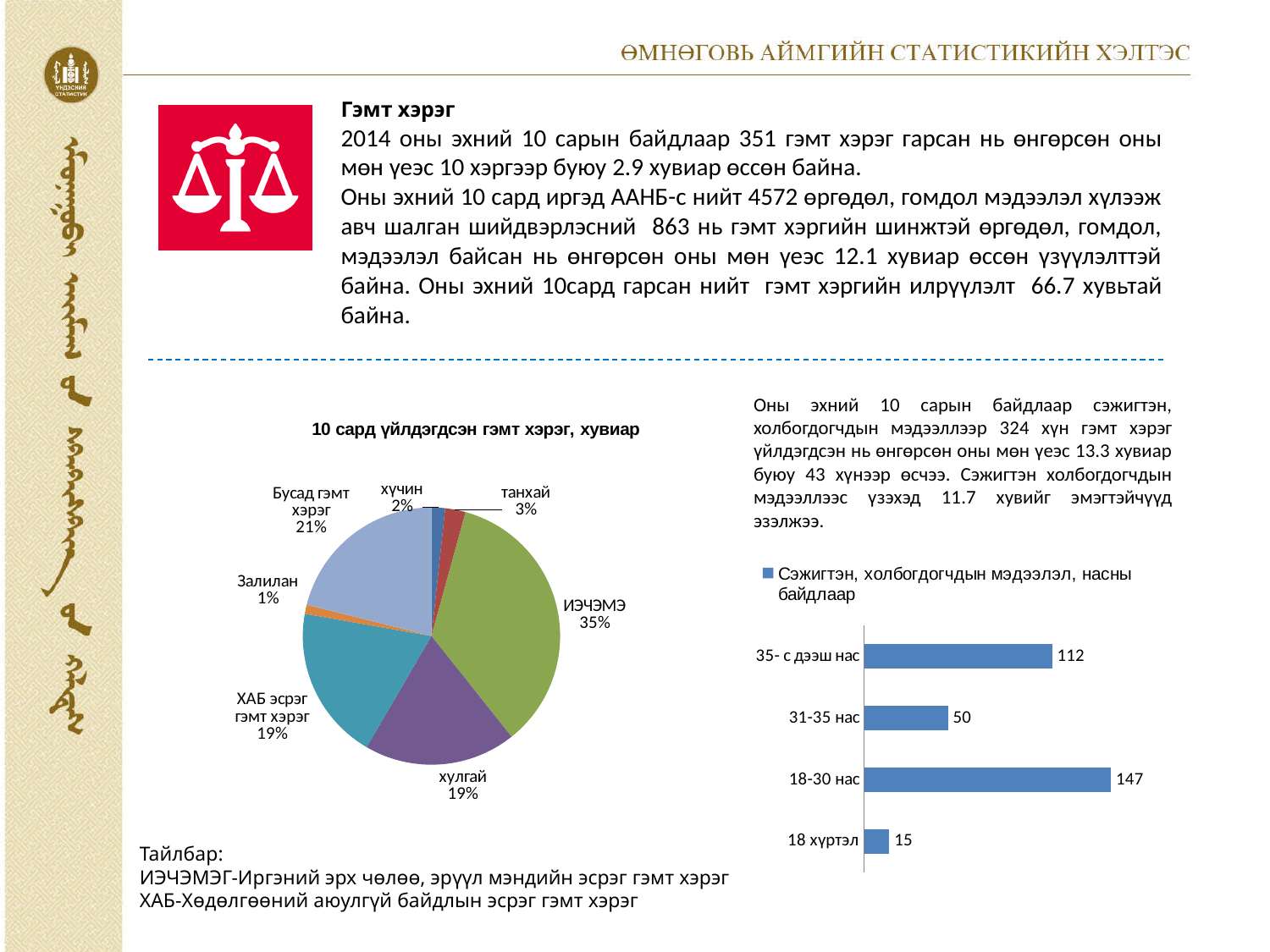
In the bar chart 'Сэжигтэн, холбогдогчдын мэдээлэл, насны байдлаар', what is the value for 31-35 нас? 50 In the bar chart 'Сэжигтэн, холбогдогчдын мэдээлэл, насны байдлаар', which is larger: 35- с дээш нас or 31-35 нас? 35- с дээш нас In the pie chart '10 сард үйлдэгдсэн гэмт хэрэг, хувиар', what is the difference between the shares of ИЭЧЭМЭ and хулгай? 16% In the bar chart 'Сэжигтэн, холбогдогчдын мэдээлэл, насны байдлаар', what is the difference between 18-30 нас and 35- с дээш нас? 35 In the bar chart 'Сэжигтэн, холбогдогчдын мэдээлэл, насны байдлаар', what is the value for 18-30 нас? 147 In the pie chart '10 сард үйлдэгдсэн гэмт хэрэг, хувиар', what share does Бусад гэмт хэрэг have? 21% In the pie chart '10 сард үйлдэгдсэн гэмт хэрэг, хувиар', how many slices are there? 7 In the pie chart '10 сард үйлдэгдсэн гэмт хэрэг, хувиар', what share does ИЭЧЭМЭ have? 35% In the pie chart '10 сард үйлдэгдсэн гэмт хэрэг, хувиар', which category has the largest share? ИЭЧЭМЭ In the bar chart 'Сэжигтэн, холбогдогчдын мэдээлэл, насны байдлаар', which age group has the lowest value? 18 хүртэл What type of chart is the one on the right side of the slide? Bar chart In the pie chart '10 сард үйлдэгдсэн гэмт хэрэг, хувиар', which category has the smallest share? Залилан